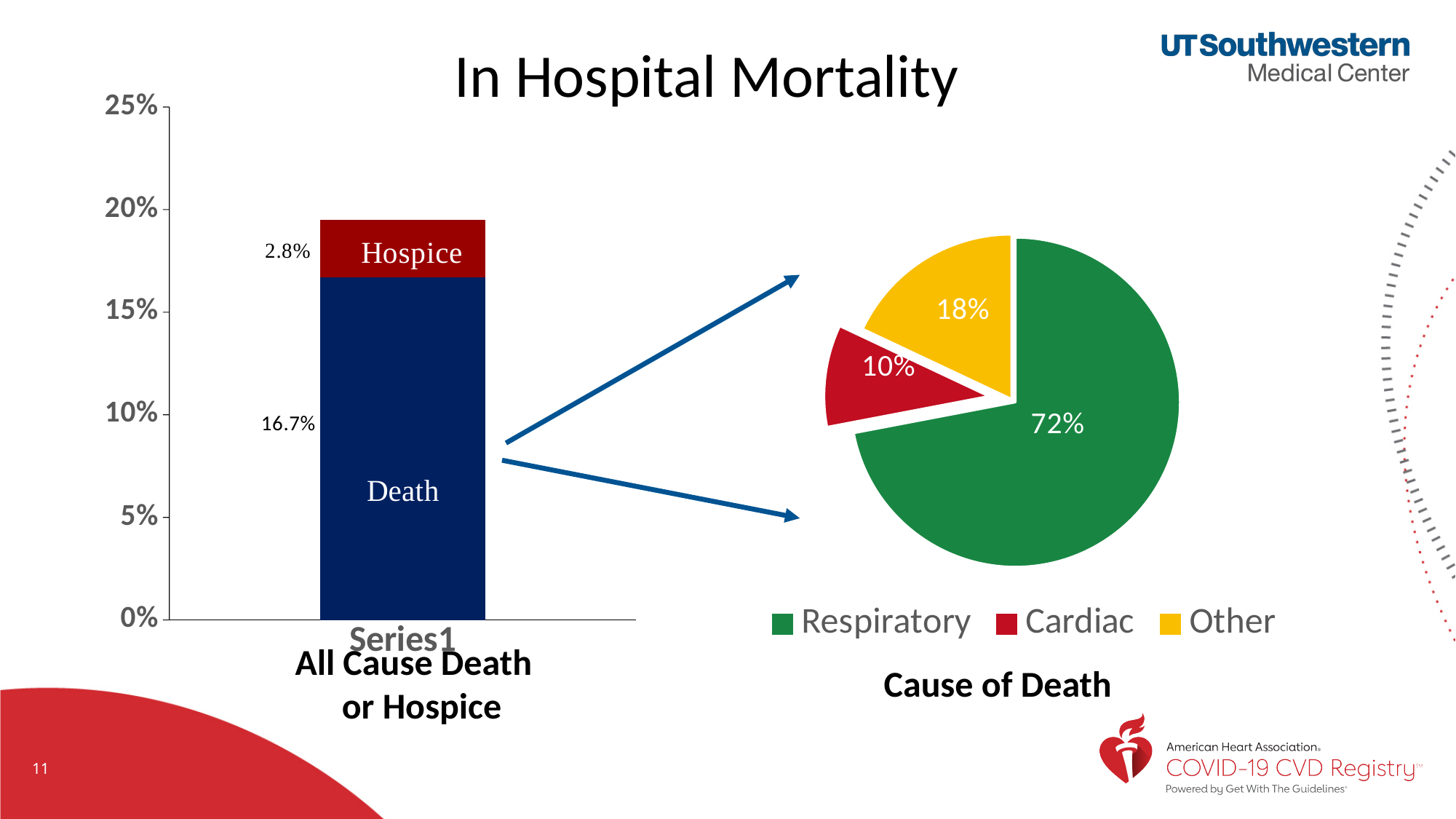
In the 'All Cause Death or Hospice' bar chart, is the top of the stacked bar greater or less than 20%? less What kind of chart is the 'All Cause Death or Hospice' chart? bar chart How many categories does the legend of the 'Cause of Death' pie chart list? 3 In the 'All Cause Death or Hospice' bar chart, what is the value for Death? 16.7% In the 'Cause of Death' pie chart, what share is Respiratory? 72% In the 'All Cause Death or Hospice' bar chart, what is the total of the stacked bar (Death plus Hospice)? 19.5% In the 'Cause of Death' pie chart, what is the difference between the Other and Cardiac shares? 8% In the 'Cause of Death' pie chart, which cause has the smallest share? Cardiac In the 'All Cause Death or Hospice' bar chart, what is the difference between the Death and Hospice values? 13.9% In the 'Cause of Death' pie chart, what share is Cardiac? 10% In the 'All Cause Death or Hospice' bar chart, which segment is larger, Death or Hospice? Death In the 'All Cause Death or Hospice' bar chart, what is the value for Hospice? 2.8%